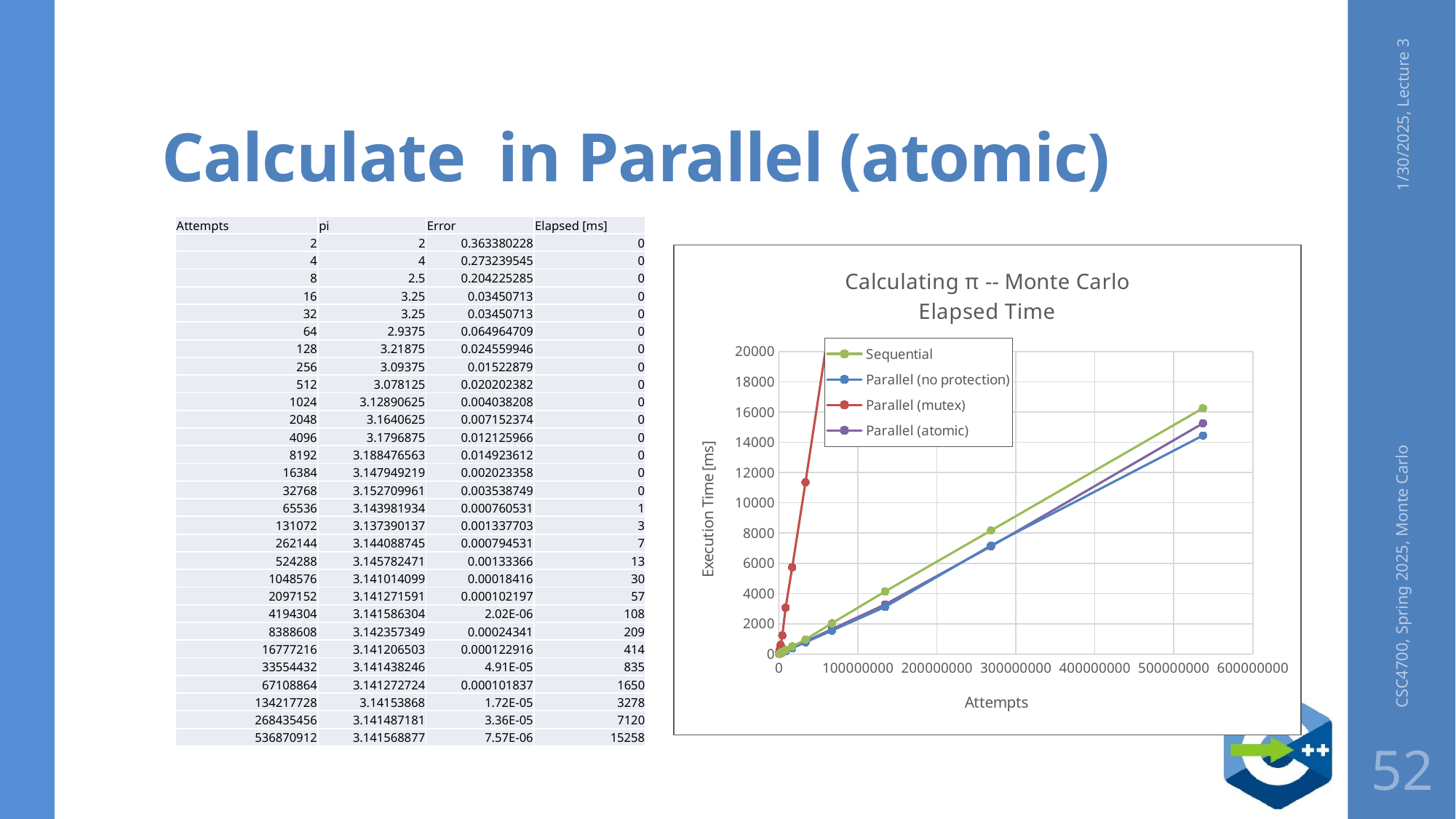
How many series does the chart legend list? 4 At the largest number of attempts plotted, which has the higher execution time: Sequential or Parallel (no protection)? Sequential At the largest number of attempts plotted, is the execution time for Parallel (no protection) greater or less than 16000? less Which series are listed in the chart legend? Sequential, Parallel (no protection), Parallel (mutex), Parallel (atomic) Is the highest plotted point of the Parallel (mutex) series that is still inside the chart area greater or less than 10000? greater At the largest number of attempts plotted, which has the higher execution time: Parallel (atomic) or Parallel (no protection)? Parallel (atomic) At the largest number of attempts plotted, is the execution time for the Sequential series greater or less than 14000? greater What kind of chart is shown on the slide? line chart Among Sequential, Parallel (no protection) and Parallel (atomic), which series has the lowest execution time at the largest number of attempts plotted? Parallel (no protection) Which series rises most steeply and goes above the top of the y axis (20000 ms)? Parallel (mutex) Does the execution time for the Sequential series rise or fall as the number of attempts increases? rise What is the title of the chart? Calculating π -- Monte Carlo Elapsed Time